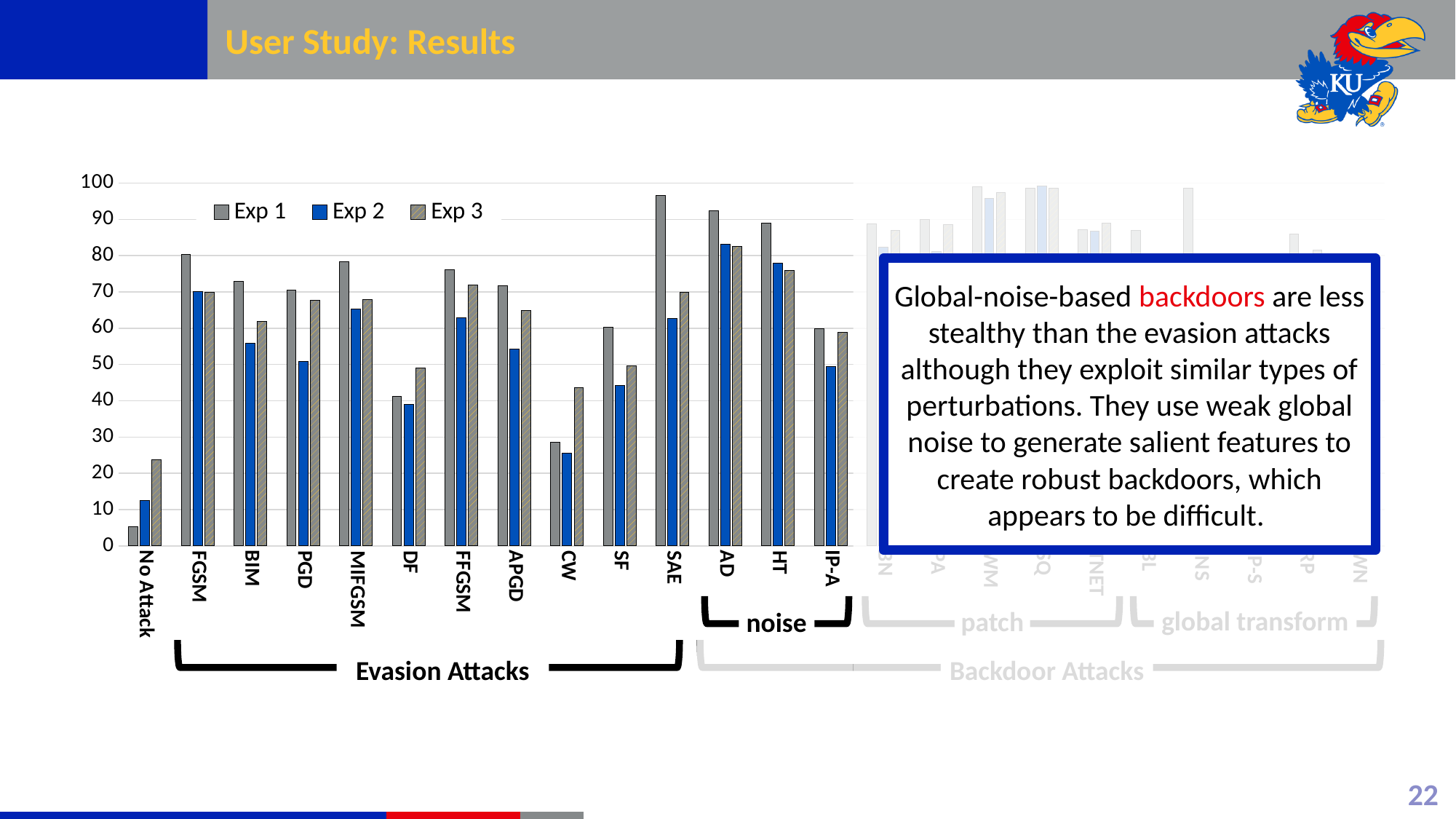
What are the series names listed in the chart's legend? Exp 1, Exp 2, Exp 3 What kind of chart is shown on the slide? bar chart Is the Exp 2 value for BIM greater or less than 50? greater Among the readable categories, which has the lowest Exp 1 value? No Attack Is the Exp 1 value for No Attack greater or less than 10? less Which is larger, the Exp 3 value for DF or the Exp 3 value for FFGSM? FFGSM Is the Exp 1 value for SAE greater or less than 90? greater Which is larger, the Exp 1 value for CW or the Exp 1 value for SF? SF How many series does the chart's legend list? 3 Which series is drawn in blue in the chart? Exp 2